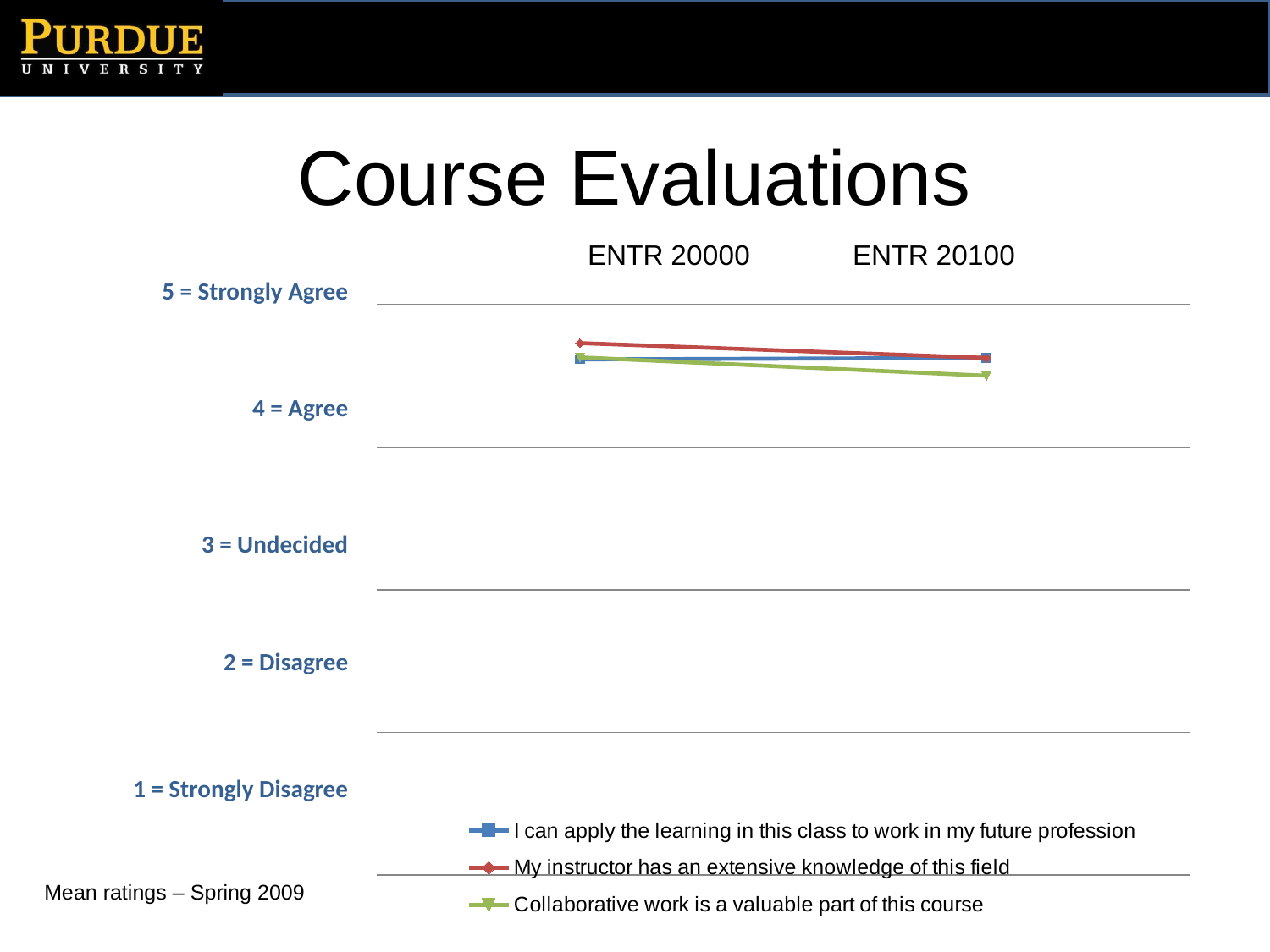
Is the value for 'My instructor has an extensive knowledge of this field' at ENTR 20000 greater or less than 5? less How many series does the legend list? 3 What is the title of the chart on the slide? Course Evaluations Is the value for 'Collaborative work is a valuable part of this course' at ENTR 20100 greater or less than 4? greater Which series has the lowest value at ENTR 20100? Collaborative work is a valuable part of this course Does the value for 'Collaborative work is a valuable part of this course' rise or fall from ENTR 20000 to ENTR 20100? fall At ENTR 20000, which is larger: the value for 'My instructor has an extensive knowledge of this field' or the value for 'Collaborative work is a valuable part of this course'? My instructor has an extensive knowledge of this field How many courses (categories) are plotted along the x axis? 2 What does the rating of 3 on the y axis stand for? Undecided What kind of chart is shown on the slide? Line chart Which series has the highest value at ENTR 20000? My instructor has an extensive knowledge of this field Is the value for 'I can apply the learning in this class to work in my future profession' at ENTR 20100 greater or less than 4? greater